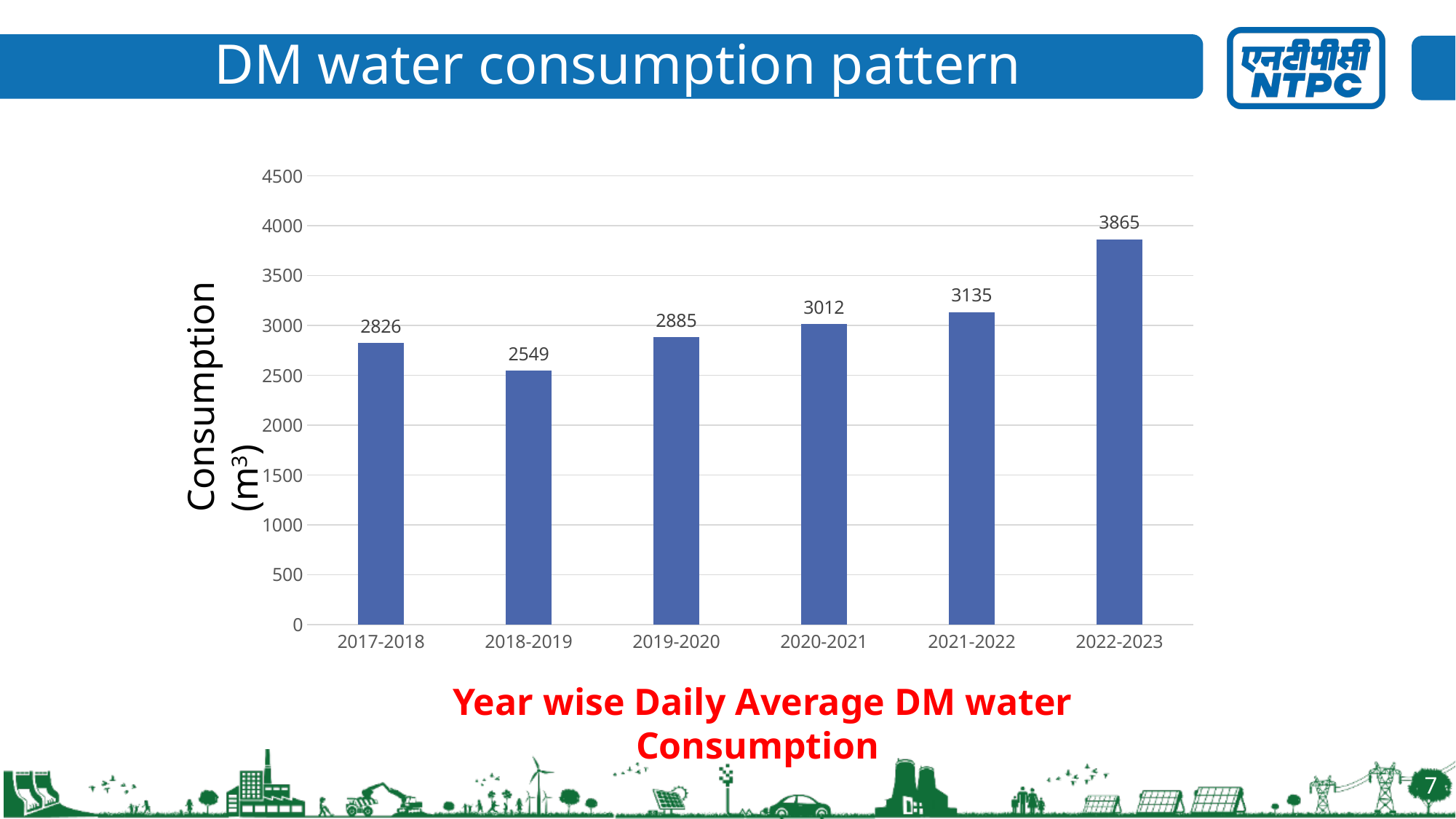
Is the value for 2018-2019 greater or less than 3000? less Which year has the highest DM water consumption? 2022-2023 What is the DM water consumption value for 2020-2021? 3012 What is the difference in DM water consumption between 2017-2018 and 2018-2019? 277 Which year has a larger DM water consumption, 2019-2020 or 2021-2022? 2021-2022 What is the label of the vertical axis of the chart? Consumption (m³) What is the difference in DM water consumption between 2022-2023 and 2021-2022? 730 Which year has the lowest DM water consumption? 2018-2019 What is the DM water consumption value for 2022-2023? 3865 What kind of chart is shown on the slide? bar chart How many years are shown on the x axis of the chart? 6 What is the DM water consumption value for 2017-2018? 2826